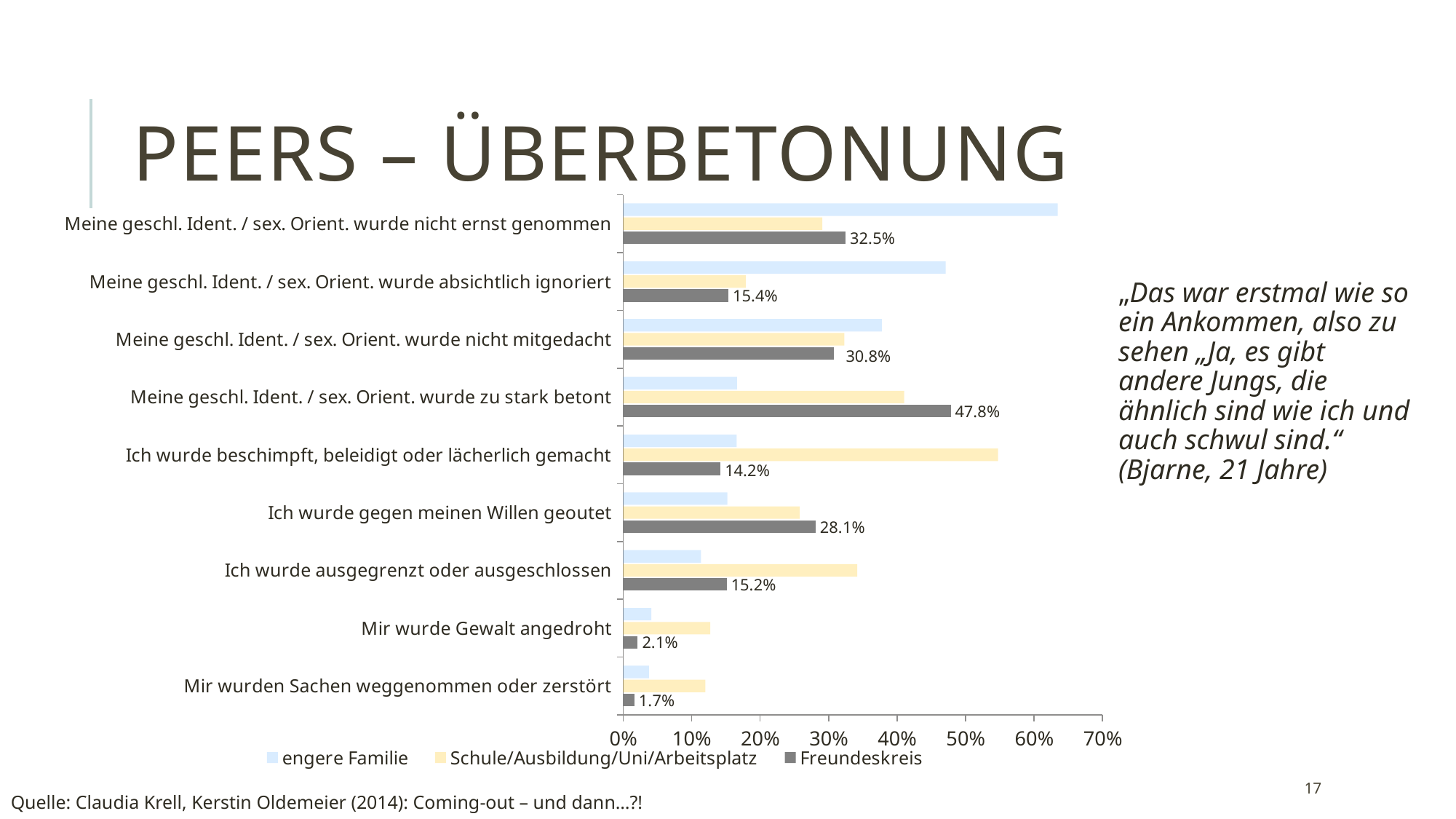
How many categories are shown on the chart? 9 How many series does the legend list? 3 Which category has the lowest Freundeskreis value? Mir wurden Sachen weggenommen oder zerstört What is the Freundeskreis value for "Meine geschl. Ident. / sex. Orient. wurde zu stark betont"? 47.8% Which is larger for "Ich wurde beschimpft, beleidigt oder lächerlich gemacht": the Schule/Ausbildung/Uni/Arbeitsplatz value or the Freundeskreis value? Schule/Ausbildung/Uni/Arbeitsplatz What is the Freundeskreis value for "Mir wurden Sachen weggenommen oder zerstört"? 1.7% Which category has the highest Freundeskreis value? Meine geschl. Ident. / sex. Orient. wurde zu stark betont What is the difference between the Freundeskreis values for "Meine geschl. Ident. / sex. Orient. wurde nicht ernst genommen" and "Meine geschl. Ident. / sex. Orient. wurde absichtlich ignoriert"? 17.1% What kind of chart is shown on the slide? bar chart What is the Freundeskreis value for "Ich wurde gegen meinen Willen geoutet"? 28.1% Which series is shown in grey in the legend? Freundeskreis Is the engere Familie value for "Meine geschl. Ident. / sex. Orient. wurde nicht ernst genommen" greater or less than 60%? greater